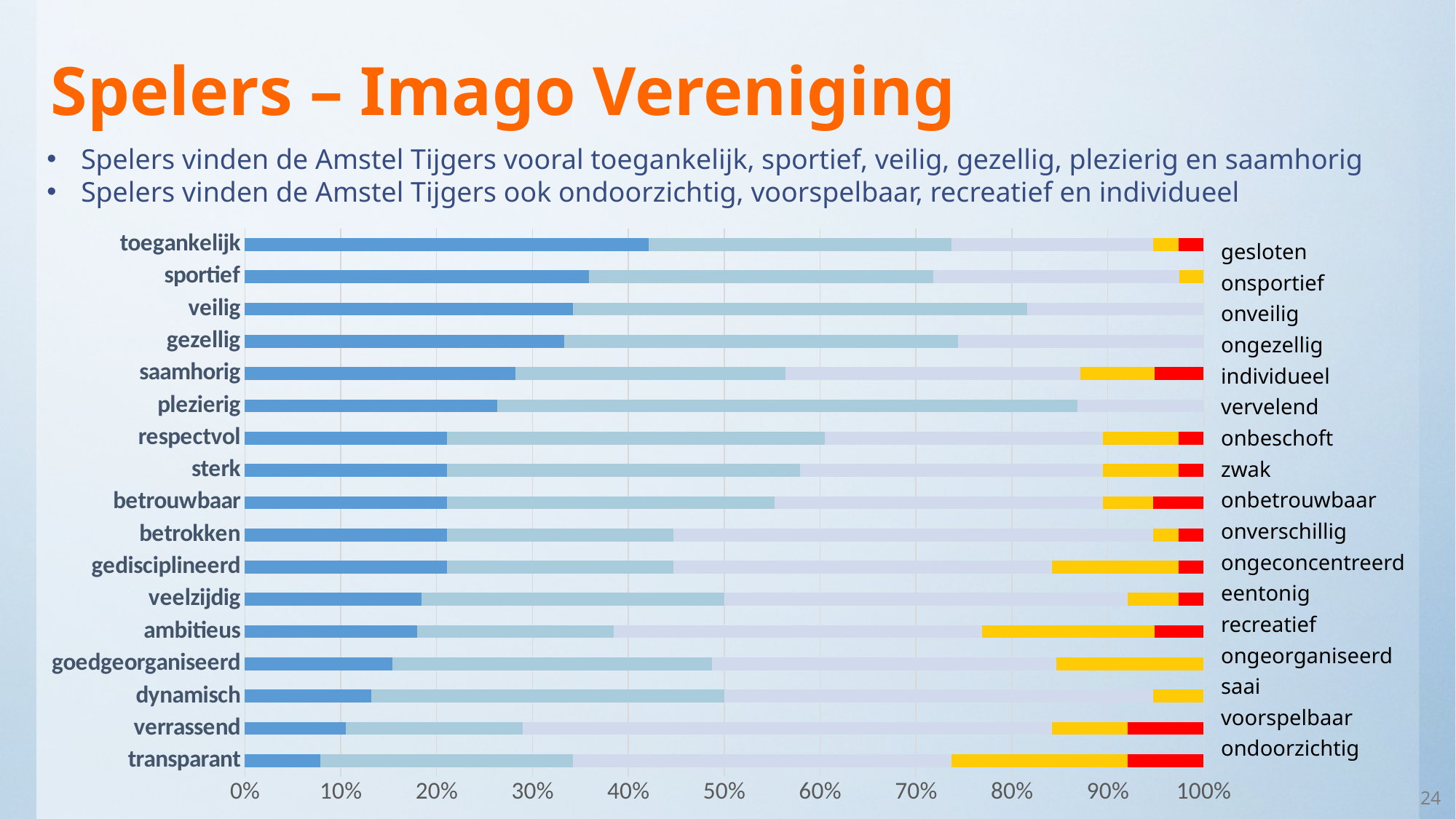
What kind of chart is shown on the slide? stacked bar chart How many categories (rows) are plotted on the chart? 17 Is the dark blue segment for toegankelijk greater or less than 30%? greater Which category has the shortest dark blue segment? transparant Is the dark blue segment for transparant greater or less than 10%? less Does the dark blue segment get longer or shorter going from the top row to the bottom row? shorter Is the dark blue segment for sportief greater or less than 30%? greater What label appears on the right-hand side opposite the row 'transparant'? ondoorzichtig Which has a longer dark blue segment, gezellig or saamhorig? gezellig Which has a longer dark blue segment, verrassend or veelzijdig? veelzijdig Which category has the longest dark blue segment? toegankelijk